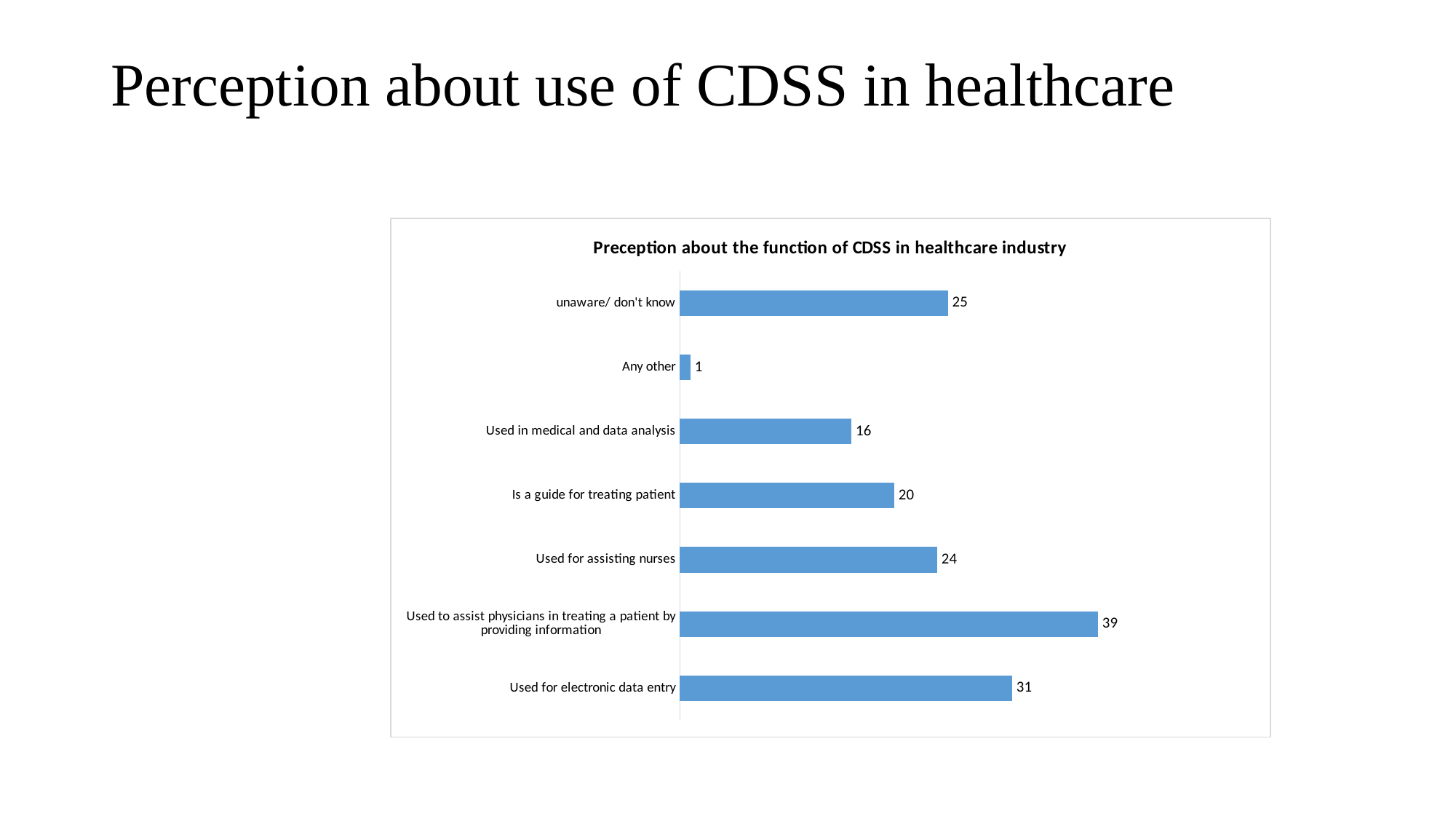
How many categories are shown in the chart? 7 What is the difference between the values for "Is a guide for treating patient" and "Used in medical and data analysis"? 4 What is the difference between the values for "Used to assist physicians in treating a patient by providing information" and "Used for electronic data entry"? 8 What is the title of the chart? Preception about the function of CDSS in healthcare industry What is the value for "Used for assisting nurses"? 24 What is the value for "unaware/ don't know"? 25 What kind of chart is shown on the slide? Bar chart Which is larger: the value for "Used for assisting nurses" or the value for "Is a guide for treating patient"? Used for assisting nurses Which category has the highest value? Used to assist physicians in treating a patient by providing information What is the value for "Used in medical and data analysis"? 16 What is the value for "Used for electronic data entry"? 31 Which category has the lowest value? Any other